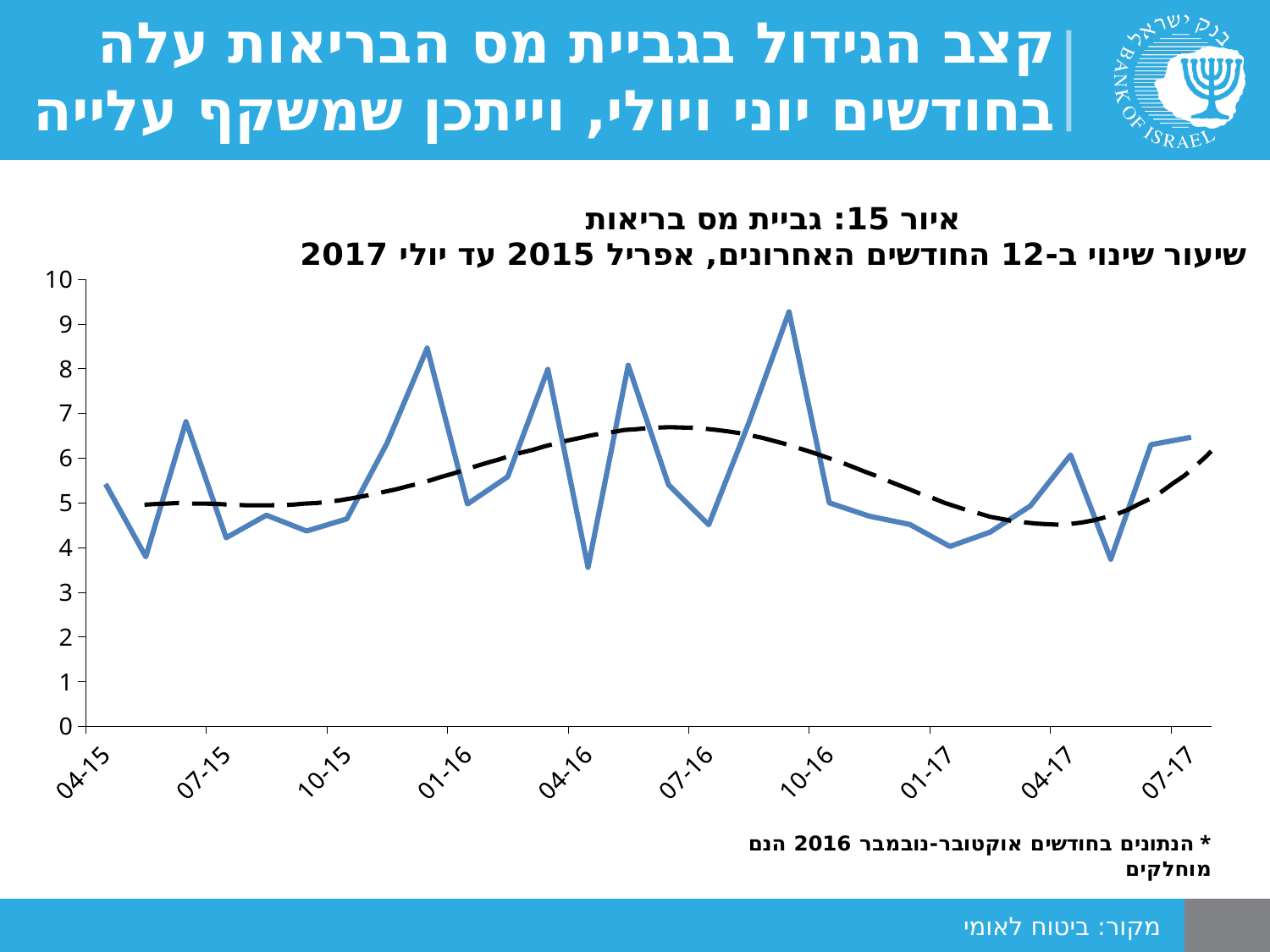
Is the value of the solid blue line at 04-15 greater or less than 5? greater Is the value of the solid blue line at 07-15 greater or less than 5? less What kind of chart is shown on the slide? line chart Does the solid blue line rise or fall between 04-16 and 07-16 overall? rise Which is larger on the solid blue line: the value at 07-17 or the value at 04-16? 07-17 Is the value of the solid blue line at 04-16 greater or less than 4? less How many labeled dates are shown on the x axis? 10 What is the title of the chart (the first line above the plot)? איור 15: גביית מס בריאות Which is larger on the solid blue line: the value at 04-15 or the value at 07-15? 04-15 What is the highest value marked on the y axis? 10